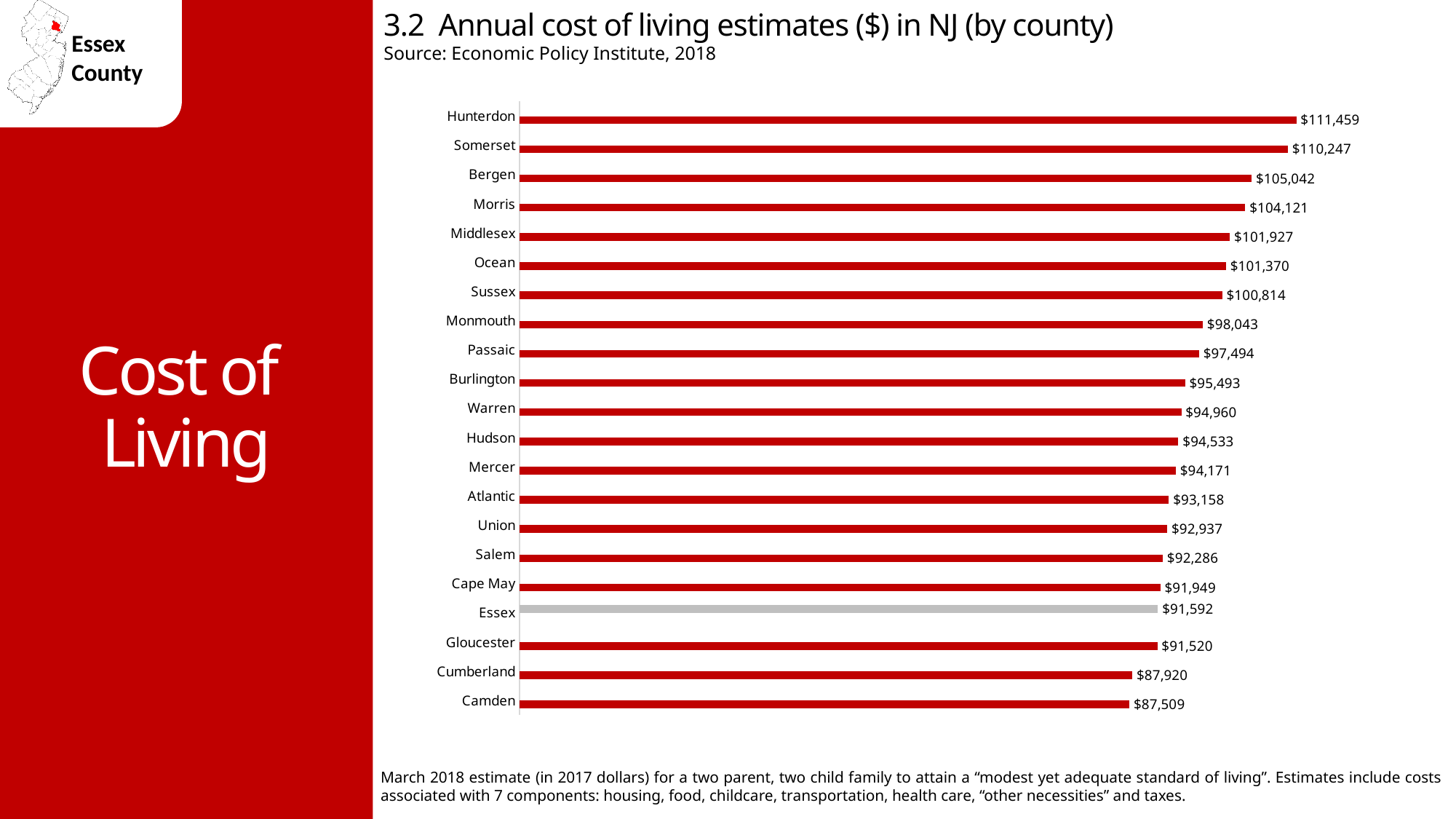
Which county has a higher cost of living estimate, Passaic or Union? Passaic Which county has the highest annual cost of living estimate? Hunterdon What is the annual cost of living estimate for Essex county? $91,592 Which county has a higher cost of living estimate, Bergen or Morris? Bergen What kind of chart is used to show the cost of living estimates? Bar chart Which county has the lowest annual cost of living estimate? Camden What is the difference between the cost of living estimates for Hunterdon and Camden? $23,950 What is the annual cost of living estimate for Monmouth county? $98,043 Which county's bar is shown in grey instead of red? Essex What is the difference between the cost of living estimates for Essex and Gloucester? $72 How many counties are shown in the chart? 21 What is the annual cost of living estimate for Hunterdon county? $111,459